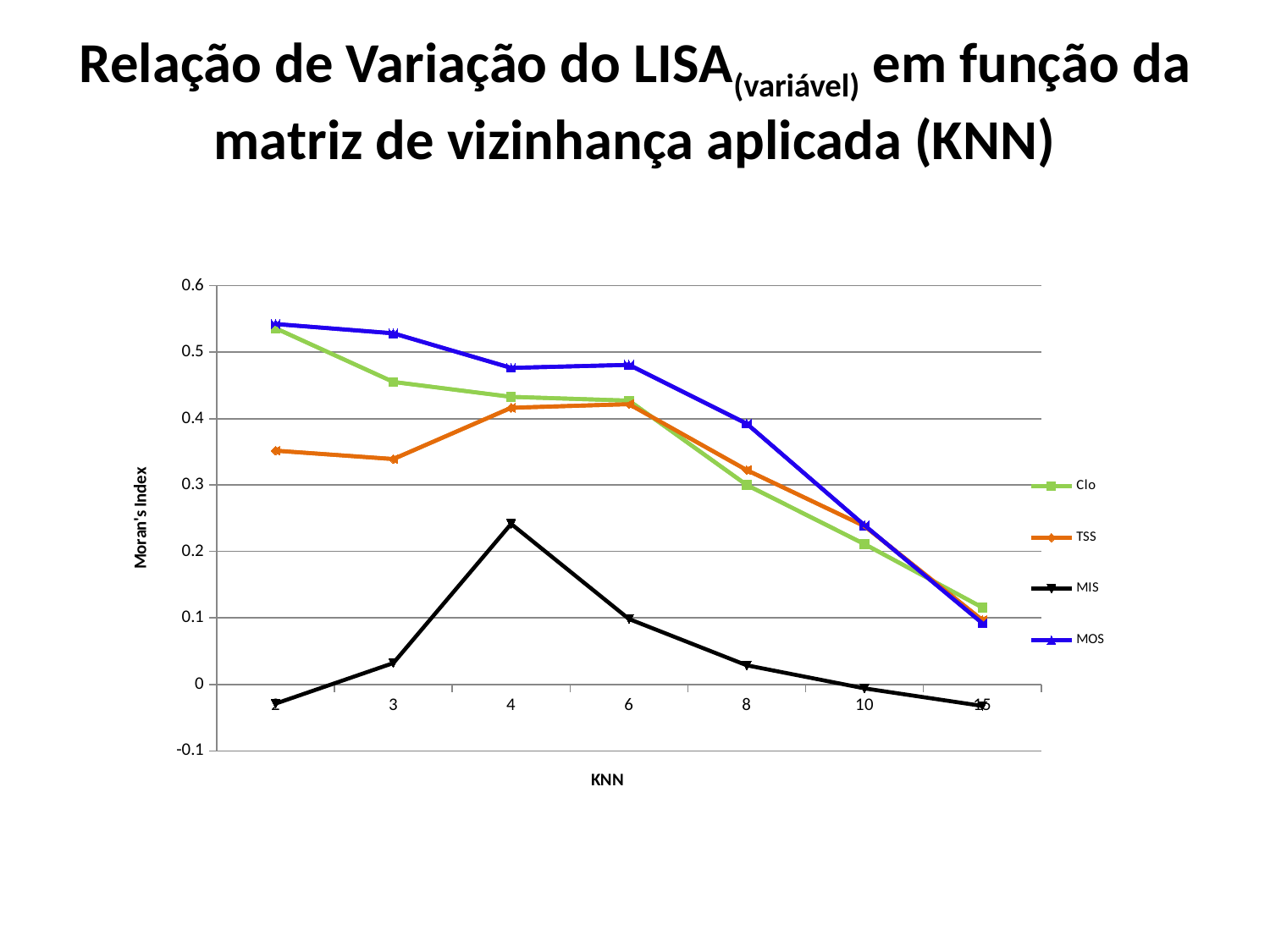
Is the value for MOS at KNN = 3 greater or less than 0.5? greater What kind of chart is shown on the slide? line chart How many series does the legend list? 4 At KNN = 4, which is larger, the value for MOS or the value for TSS? MOS Is the value for TSS at KNN = 3 greater or less than 0.4? less Which series has the lowest value at KNN = 8? MIS Which series has the highest value at KNN = 6? MOS Is the value for MIS at KNN = 4 greater or less than 0.2? greater What is the title of the horizontal axis? KNN What is the title of the vertical axis? Moran's Index Does the MOS series rise or fall as KNN increases? fall